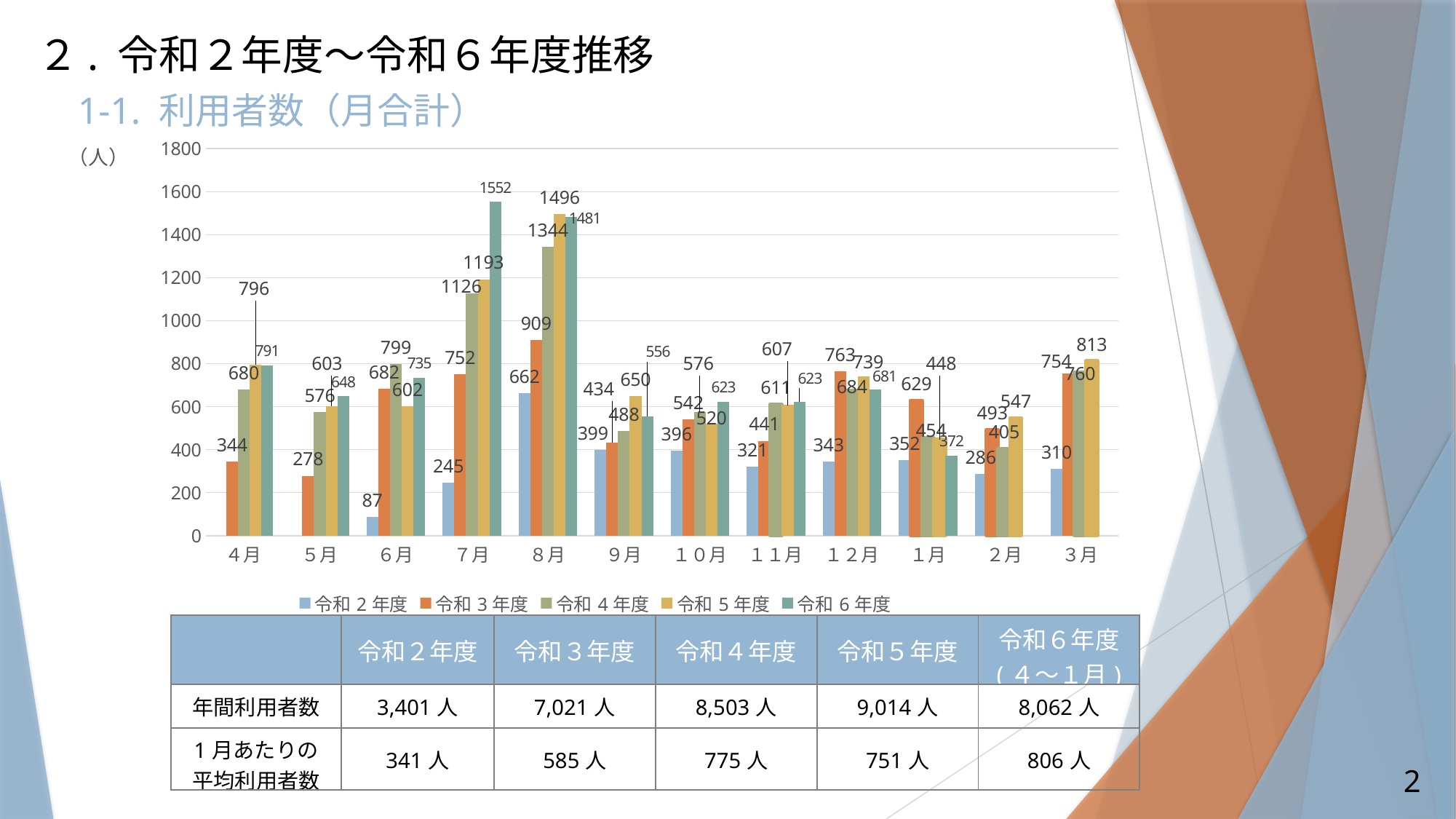
What is the value for 令和２年度 in ６月? 87 What is the value for 令和５年度 in ３月? 813 Which is larger in ８月: the 令和５年度 value or the 令和４年度 value? 令和５年度 What type of chart is shown on the slide? bar chart How many month categories are shown on the x axis? 12 In which month is the 令和３年度 value lowest? ５月 What is the value for 令和３年度 in １２月? 763 What is the value for 令和６年度 in ７月? 1552 In which month is the 令和５年度 value highest? ８月 What is the difference between the 令和６年度 and 令和５年度 values in ７月? 359 What unit is shown at the top left of the y axis? （人） How many series does the legend list? 5